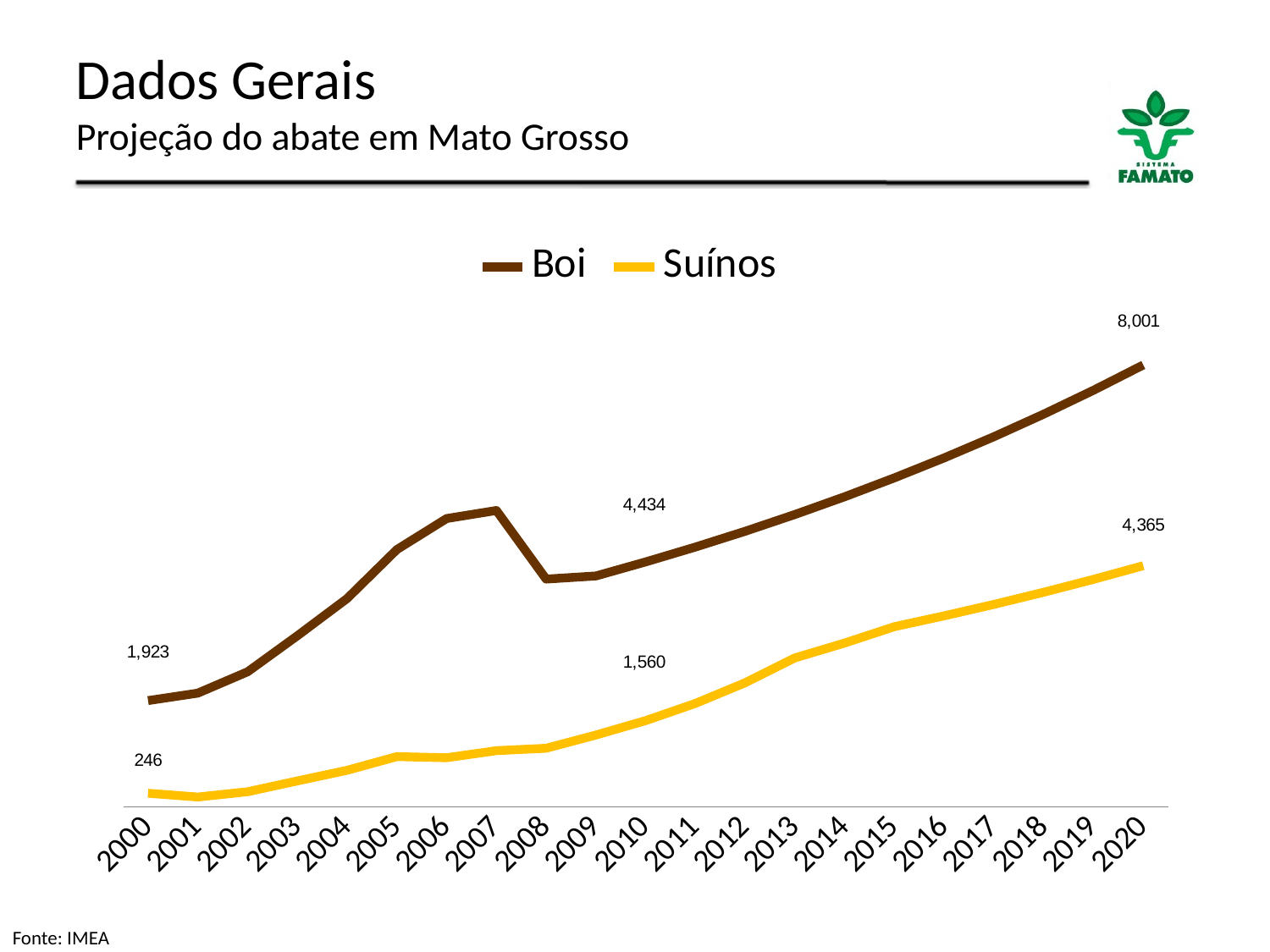
By how much does the Boi value in 2020 exceed the Boi value in 2000? 6,078 What is the value for Boi in 2020? 8,001 How many series does the legend list? 2 What is the value for Suínos in 2020? 4,365 How many years are shown on the x axis? 21 What is the value for Suínos in 2000? 246 Which series has the larger value in 2010, Boi or Suínos? Boi What is the value for Boi in 2000? 1,923 What type of chart is shown on the slide? line chart In which year is the Boi series at its lowest? 2000 What are the two series named in the legend? Boi and Suínos What is the difference between the Boi and Suínos values in 2020? 3,636